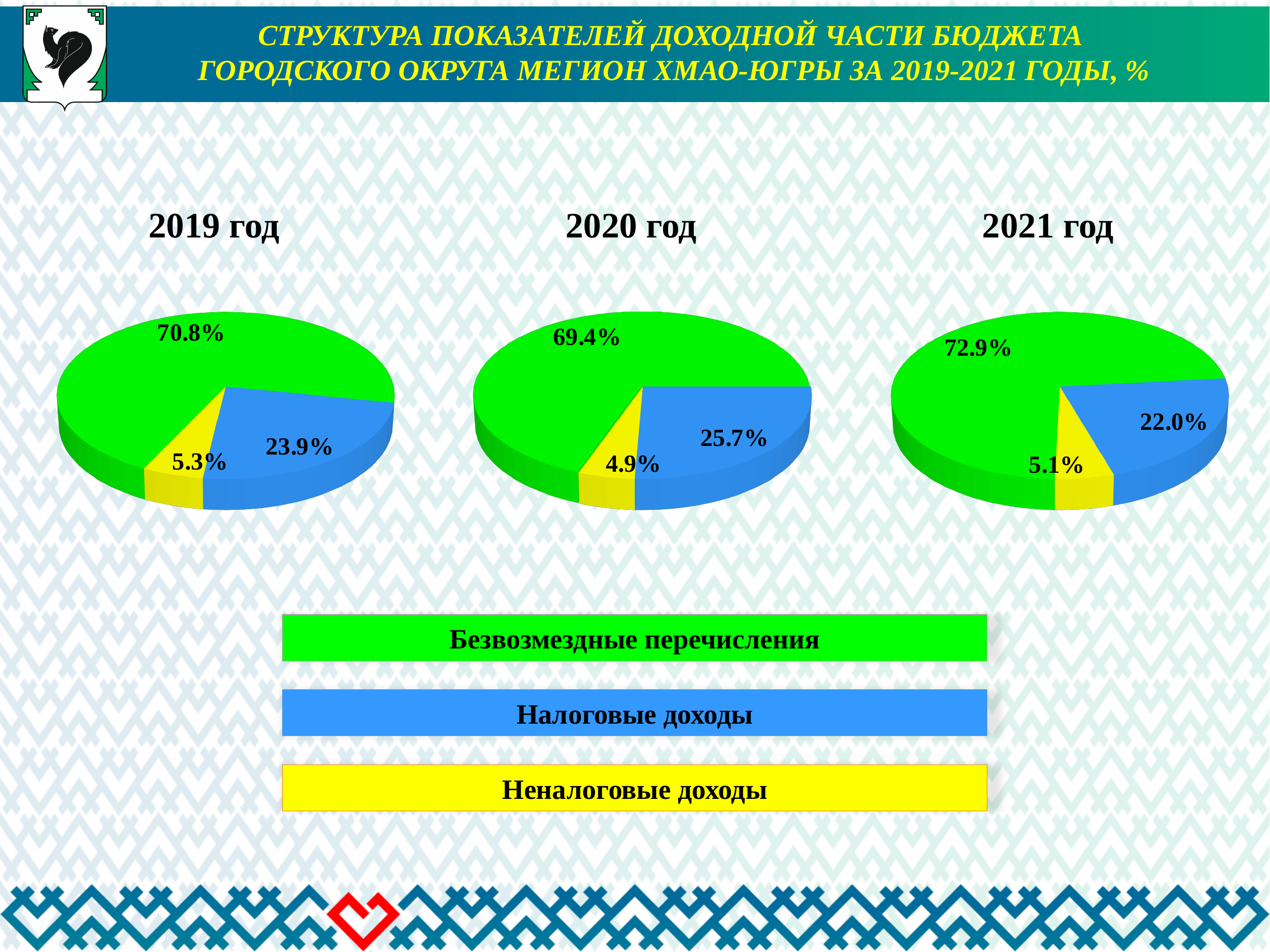
In the 2019 год pie chart, which category has the largest slice? Безвозмездные перечисления In the 2021 год pie chart, what share is Безвозмездные перечисления? 72.9% In the 2021 год pie chart, what share is Неналоговые доходы? 5.1% What is the difference between the Налоговые доходы share in the 2019 год chart and in the 2021 год chart? 1.9% In the 2020 год pie chart, what share is Налоговые доходы? 25.7% In the 2020 год pie chart, which category has the smallest slice? Неналоговые доходы How many pie charts are shown on the slide? 3 What type of chart is used for each year on the slide? Pie chart Which is larger: the Безвозмездные перечисления share in the 2020 год chart or in the 2021 год chart? 2021 год Which colour represents Налоговые доходы in the legend? Blue In the 2019 год pie chart, what share is Безвозмездные перечисления? 70.8% How many slices does the 2019 год pie chart have? 3